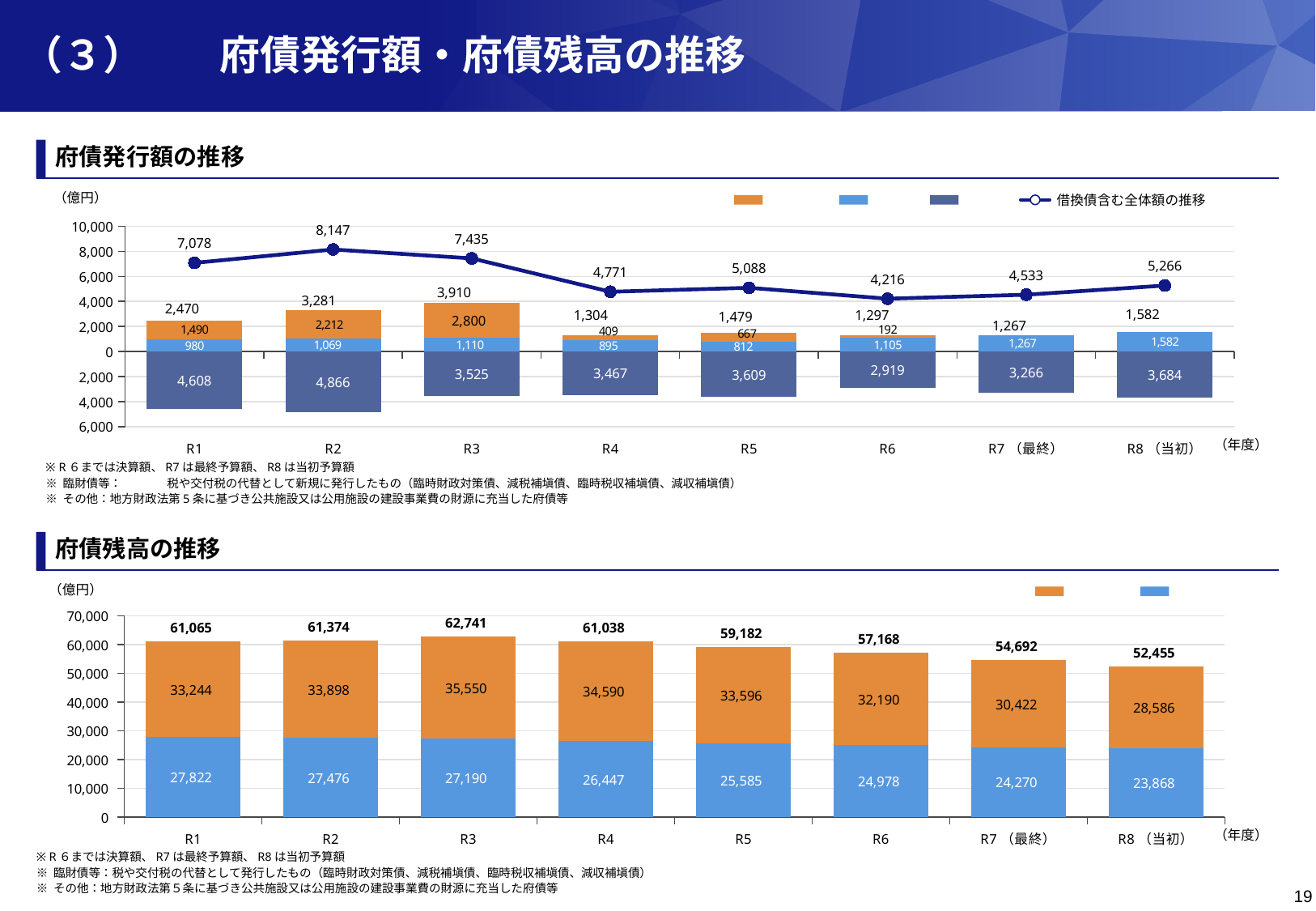
In the top chart (府債発行額の推移), which year has the lowest value on the 借換債含む全体額の推移 line? R6 In the top chart (府債発行額の推移), what is the value of the dark blue segment below the zero line for R1? 4,608 In the top chart (府債発行額の推移), what is the difference between the line values for R1 and R4? 2,307 In the top chart (府債発行額の推移), what is the total labelled above the stacked bar for R3? 3,910 In the top chart (府債発行額の推移), which year has the highest value on the 借換債含む全体額の推移 line? R2 In the bottom chart (府債残高の推移), what is the total labelled above the bar for R3? 62,741 In the bottom chart (府債残高の推移), what is the value of the light blue segment for R5? 25,585 In the bottom chart (府債残高の推移), which year has the lowest total? R8（当初） How many years are shown on the x axis of the bottom chart (府債残高の推移)? 8 In the bottom chart (府債残高の推移), do the totals rise or fall from R4 to R8? fall In the top chart (府債発行額の推移), what is the value of the 借換債含む全体額の推移 line for R2? 8,147 In the bottom chart (府債残高の推移), is the orange segment for R1 larger or smaller than the orange segment for R8? larger